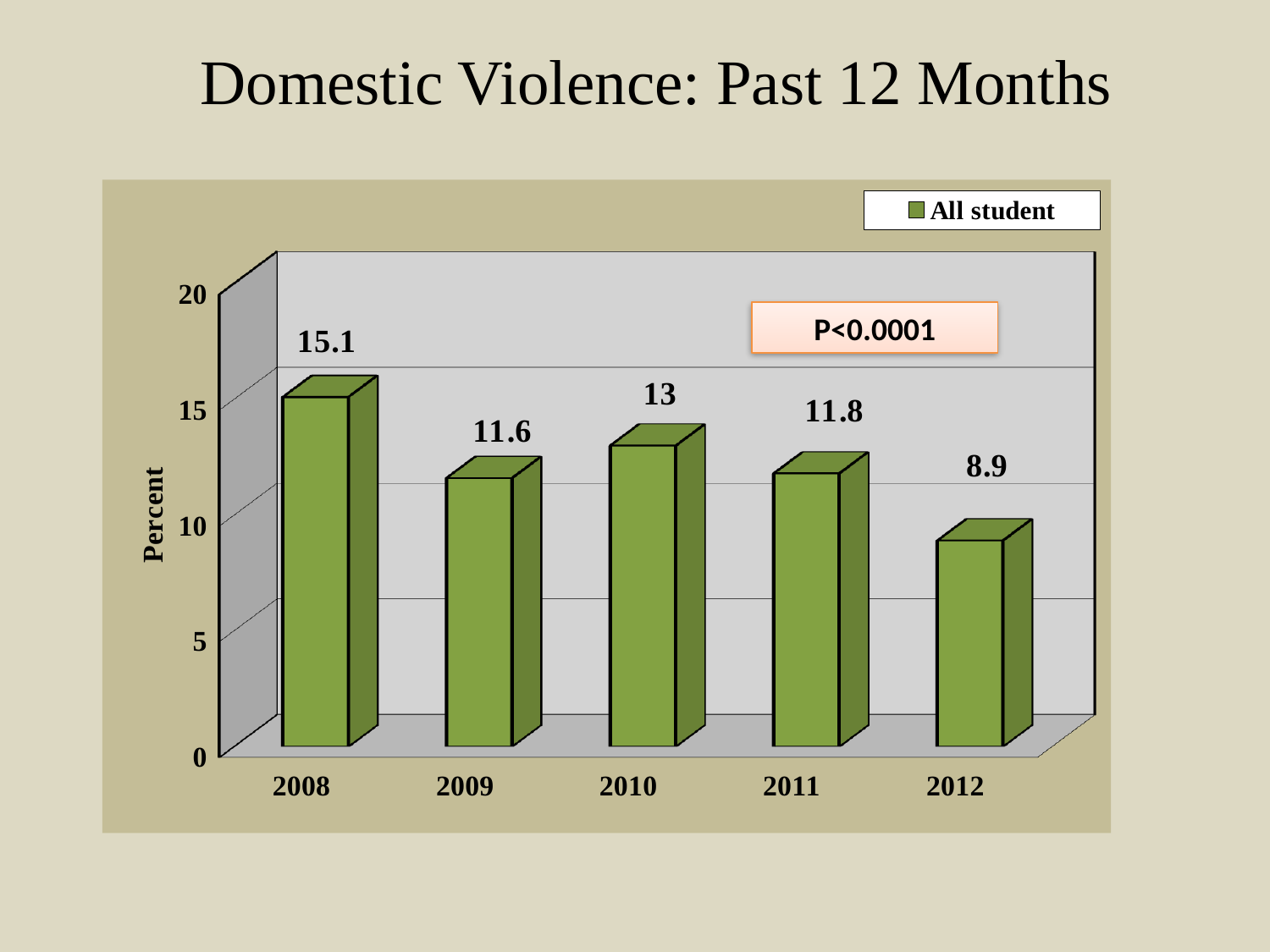
What is the value for 2012? 8.9 Which year has the lowest value? 2012 What is the difference between the values for 2008 and 2012? 6.2 How many years are shown on the x axis? 5 Which is larger, the value for 2009 or the value for 2010? 2010 What kind of chart is shown? bar chart How many series does the legend list? 1 What is the label on the y axis? Percent What is the value for 2008? 15.1 Which year has the highest value? 2008 What is the value for 2010? 13 Is the value for 2011 greater or less than 10? greater